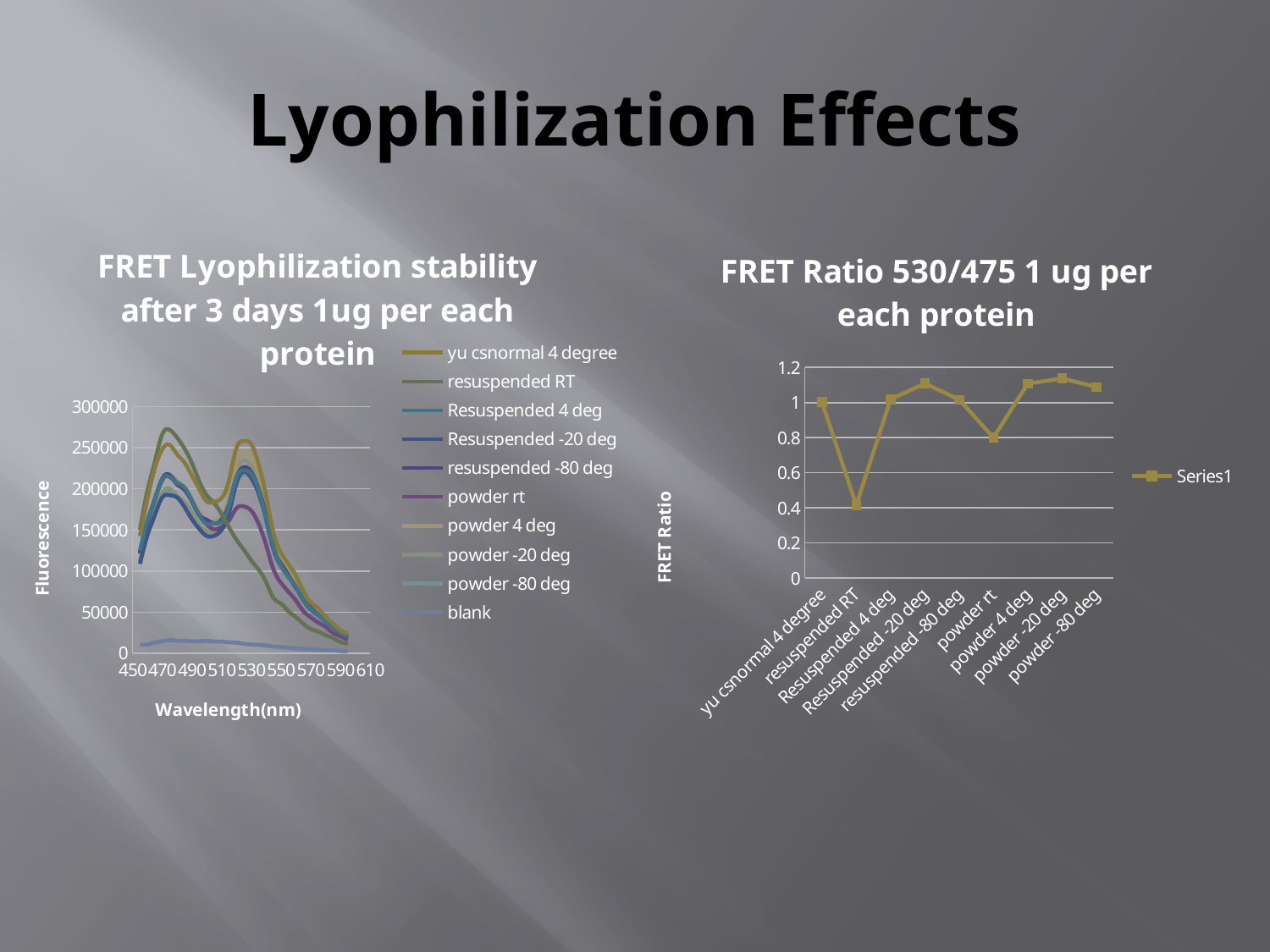
In the left chart, 'FRET Lyophilization stability after 3 days 1ug per each protein', which series has the lowest fluorescence across the wavelength range? blank How many series does the legend of the right chart, 'FRET Ratio 530/475 1 ug per each protein', list? 1 How many series does the legend of the left chart, 'FRET Lyophilization stability after 3 days 1ug per each protein', list? 10 What is the x-axis title of the left chart, 'FRET Lyophilization stability after 3 days 1ug per each protein'? Wavelength(nm) What kind of chart is the 'FRET Lyophilization stability after 3 days 1ug per each protein' chart on the left? line chart In the right chart, 'FRET Ratio 530/475 1 ug per each protein', is the value for Resuspended -20 deg greater or less than 1? greater In the right chart, 'FRET Ratio 530/475 1 ug per each protein', which category has the lowest FRET ratio? resuspended RT In the right chart, 'FRET Ratio 530/475 1 ug per each protein', which is larger: the value for powder rt or the value for resuspended RT? powder rt How many categories are shown on the x axis of the right chart, 'FRET Ratio 530/475 1 ug per each protein'? 9 In the right chart, 'FRET Ratio 530/475 1 ug per each protein', is the value for resuspended RT greater or less than 0.6? less What kind of chart is the 'FRET Ratio 530/475 1 ug per each protein' chart on the right? line chart In the right chart, 'FRET Ratio 530/475 1 ug per each protein', is the value for powder rt greater or less than 1? less